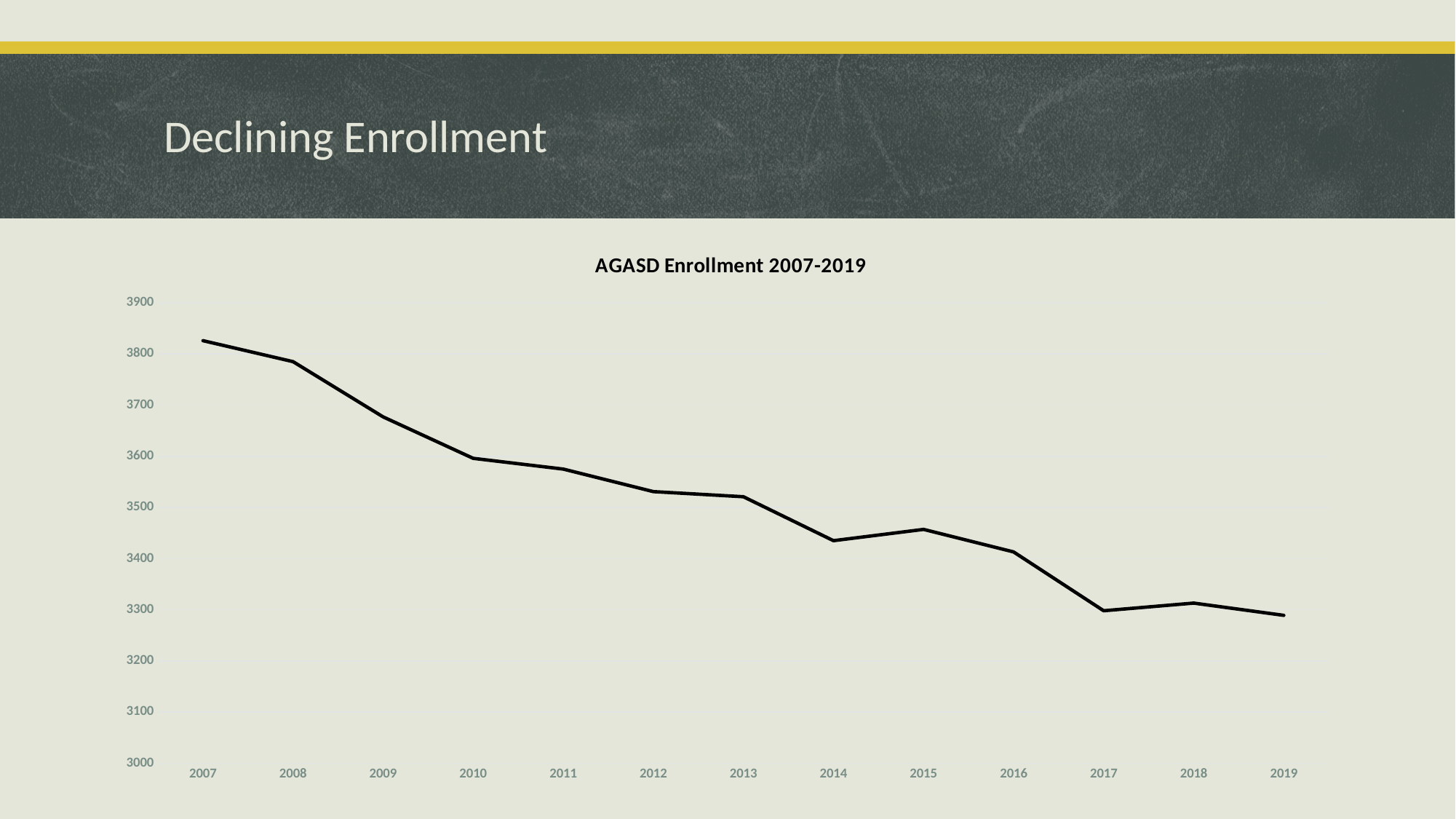
Is the enrollment value for 2014 greater or less than 3400? greater Do the enrollment values generally rise or fall from 2007 to 2019? Fall Is the enrollment value for 2009 greater or less than 3700? less What kind of chart is shown on the slide? Line chart Is the enrollment value for 2008 greater or less than 3800? less What is the title of the chart? AGASD Enrollment 2007-2019 Which year has the larger enrollment, 2014 or 2015? 2015 Which year has the highest enrollment on the chart? 2007 Which year has the larger enrollment, 2007 or 2019? 2007 How many years are plotted on the x axis of the chart? 13